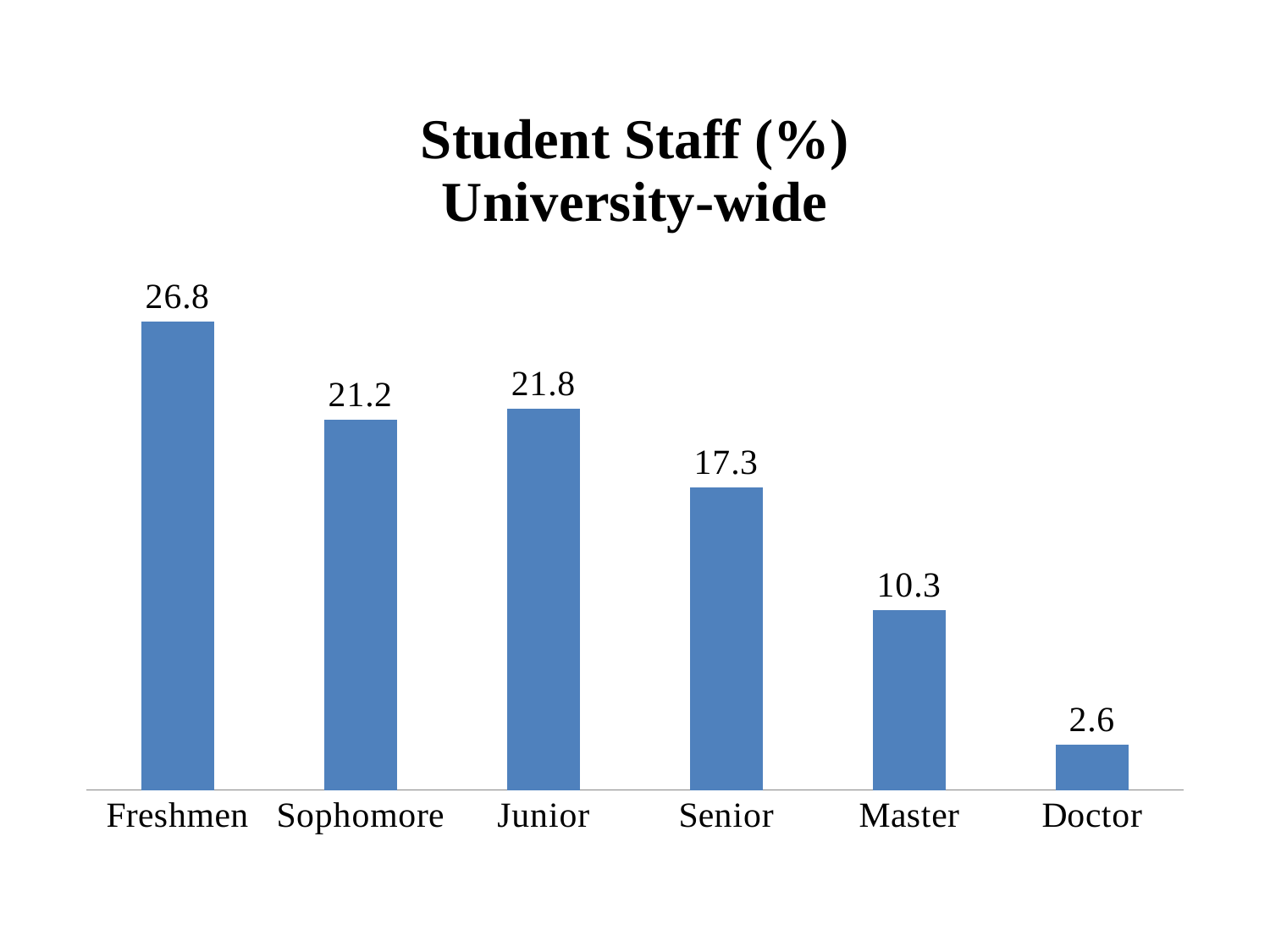
What is the value for Senior? 17.3 Which category has the lowest value? Doctor Which is larger, the value for Senior or the value for Master? Senior What is the difference between the values for Junior and Sophomore? 0.6 How many categories are shown on the x axis? 6 What is the title of the chart? Student Staff (%) University-wide What kind of chart is this? Bar chart What is the value for Master? 10.3 What is the difference between the values for Freshmen and Doctor? 24.2 What colour are the bars? Blue What is the value for Freshmen? 26.8 Which category has the highest value? Freshmen